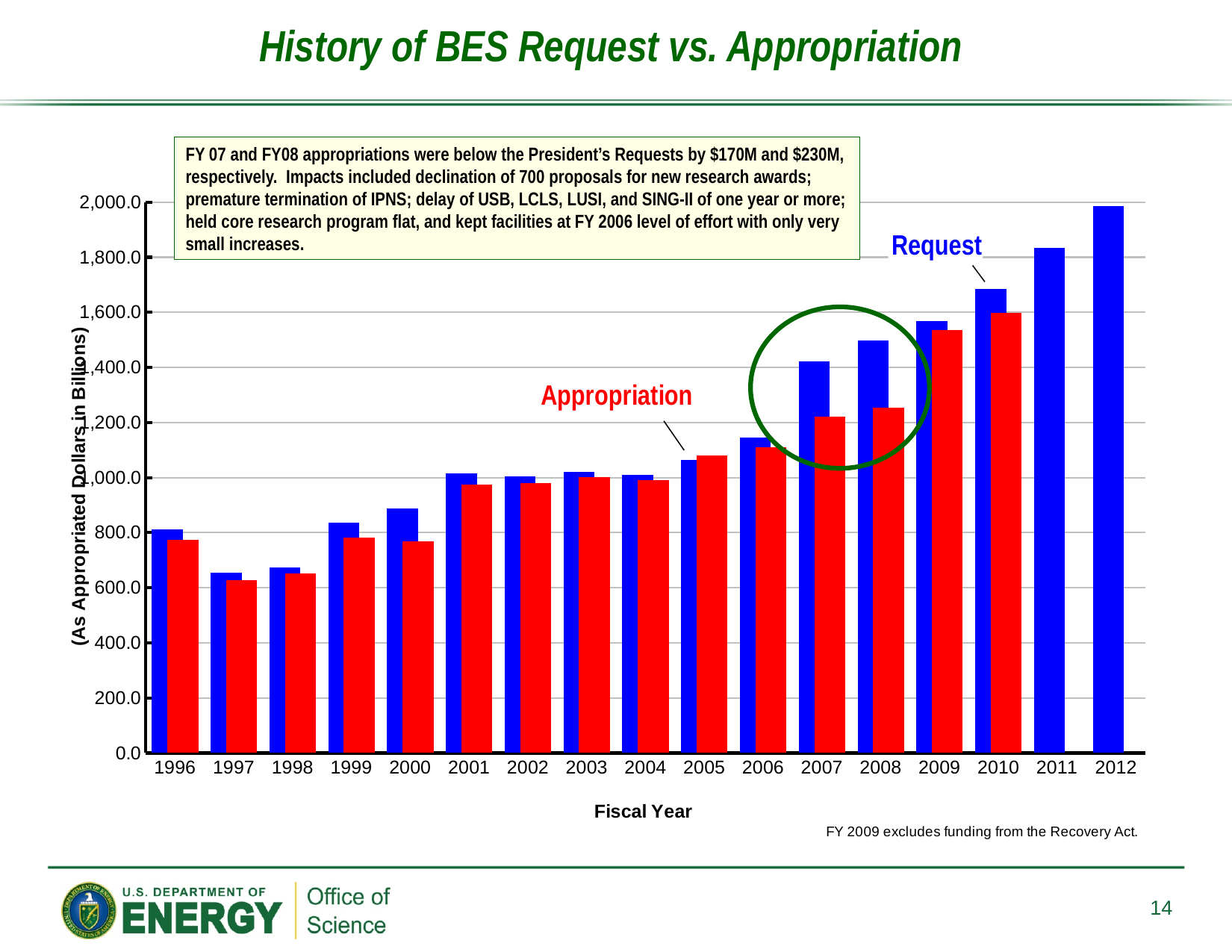
For fiscal year 2008, which is larger, the Request or the Appropriation? Request What is the title of the x axis of the chart? Fiscal Year Do the Request values rise or fall from 2006 to 2012? rise How many data series does the chart plot? 2 Is the Appropriation value for 2007 greater or less than 1,400.0? less Is the Request value for 2010 greater or less than 1,600.0? greater Is the Request value for 2012 greater or less than 1,800.0? greater What kind of chart is shown on the slide? bar chart Which colour are the Request bars in the chart? blue How many fiscal years are shown on the x axis of the chart? 17 Which fiscal year has the highest Request value? 2012